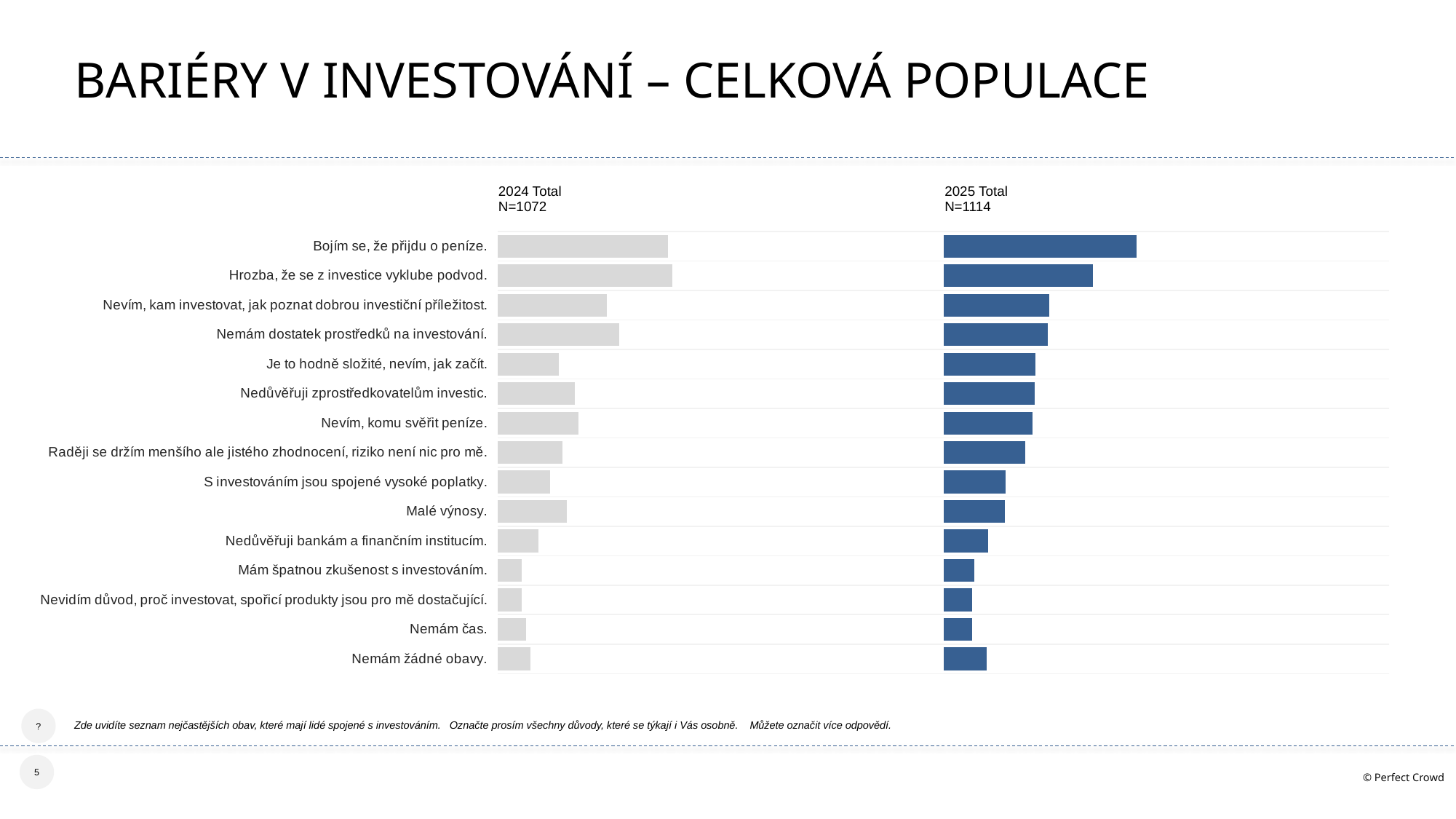
In the 2024 Total chart, which bar is longer: 'Bojím se, že přijdu o peníze.' or 'Nevím, kam investovat, jak poznat dobrou investiční příležitost.'? Bojím se, že přijdu o peníze. What is the sample size (N) shown for the 2025 Total chart? N=1114 In the 2025 Total chart, which bar is longer: 'Malé výnosy.' or 'Nedůvěřuji bankám a finančním institucím.'? Malé výnosy. What is the sample size (N) shown for the 2024 Total chart? N=1072 What kind of chart is used on this slide? bar chart In the 2025 Total chart, which bar is longer: 'Nemám žádné obavy.' or 'Nemám čas.'? Nemám žádné obavy. In the 2025 Total chart, which category has the longest bar? Bojím se, že přijdu o peníze. In the 2025 Total chart, which category has the second longest bar? Hrozba, že se z investice vyklube podvod. How many barrier categories are listed on the slide? 15